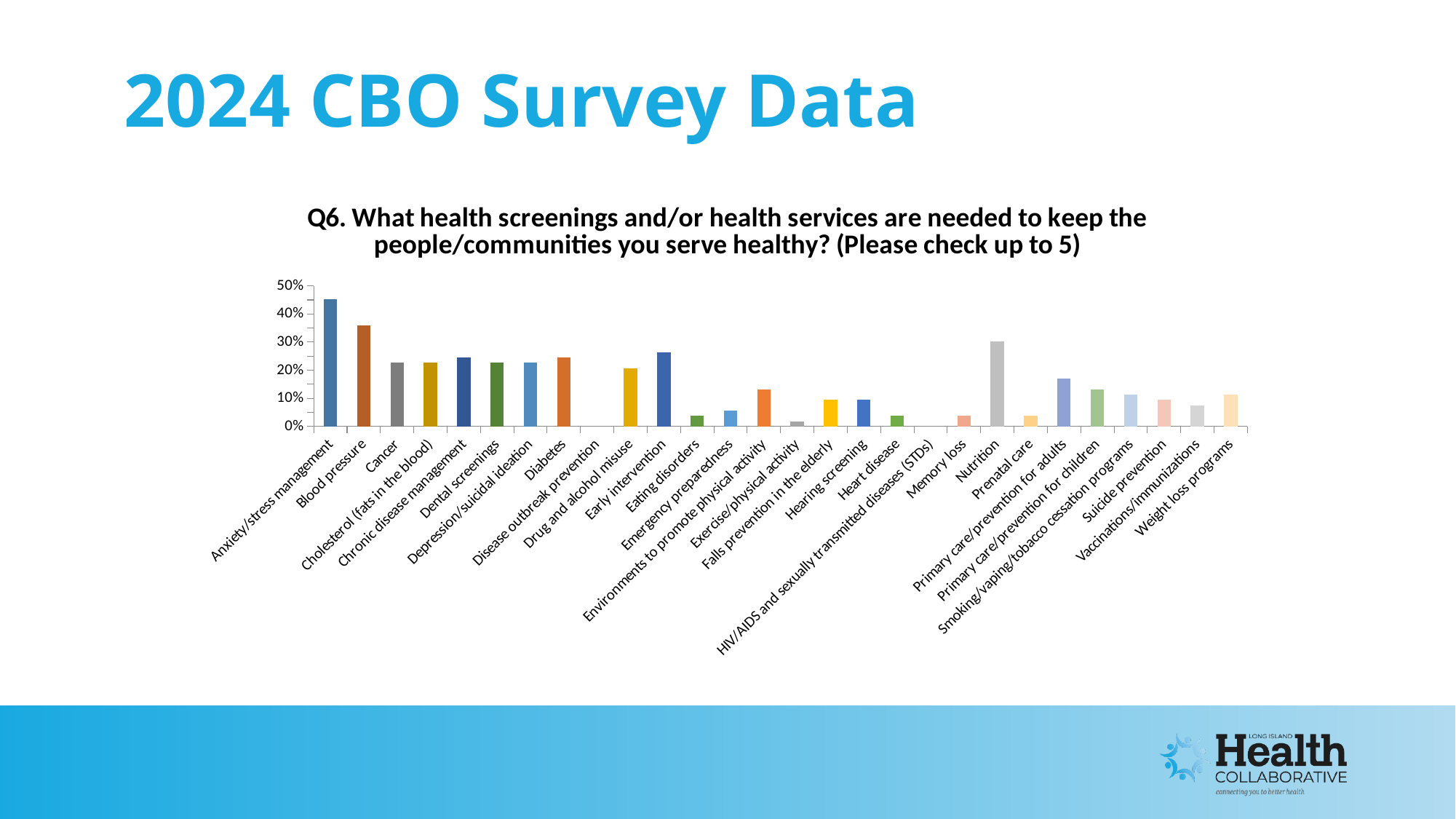
Is the value for Eating disorders greater or less than 10%? less What kind of chart is shown on the slide? Bar chart Is the value for Anxiety/stress management greater or less than 40%? greater Is the value for Blood pressure greater or less than 30%? greater What is the highest value shown on the y axis of the chart? 50% How many categories are shown on the x axis of the chart? 28 Which is larger, the value for Primary care/prevention for adults or the value for Primary care/prevention for children? Primary care/prevention for adults Which is larger, the value for Blood pressure or the value for Nutrition? Blood pressure Which category has the highest value in the chart? Anxiety/stress management